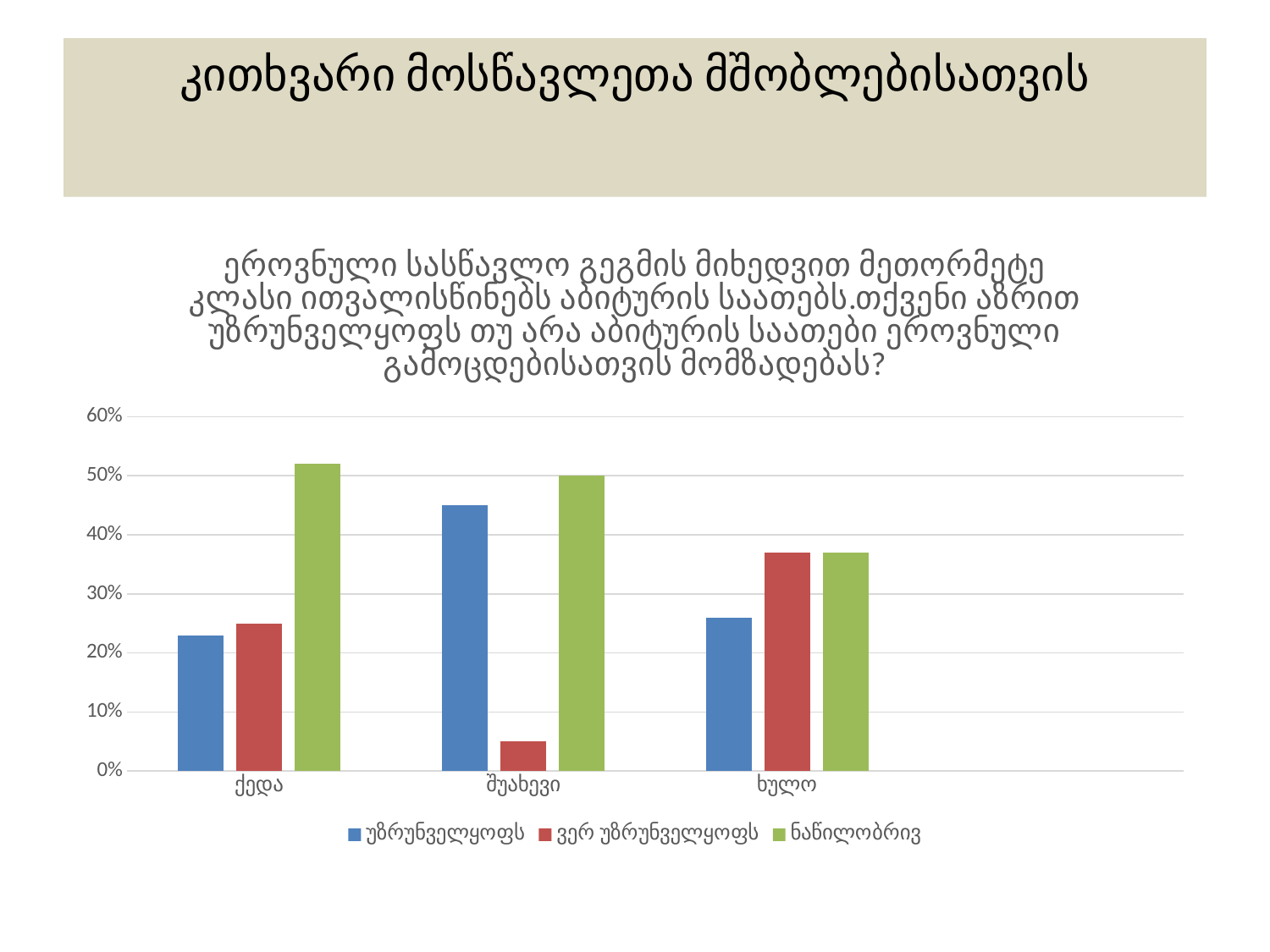
How many series does the chart legend list? 3 Which is larger in ქედა: უზრუნველყოფს or ნაწილობრივ? ნაწილობრივ Is the value for ვერ უზრუნველყოფს in შუახევი greater or less than 10%? less Which series is shown in green in the chart? ნაწილობრივ Is the value for უზრუნველყოფს in ხულო greater or less than 30%? less Is the value for უზრუნველყოფს in შუახევი greater or less than 40%? greater Which category has the highest value for უზრუნველყოფს? შუახევი Which category has the lowest value for ვერ უზრუნველყოფს? შუახევი What kind of chart is shown on the slide? bar chart How many categories are shown on the x axis of the chart? 3 What is the title of the slide? კითხვარი მოსწავლეთა მშობლებისათვის